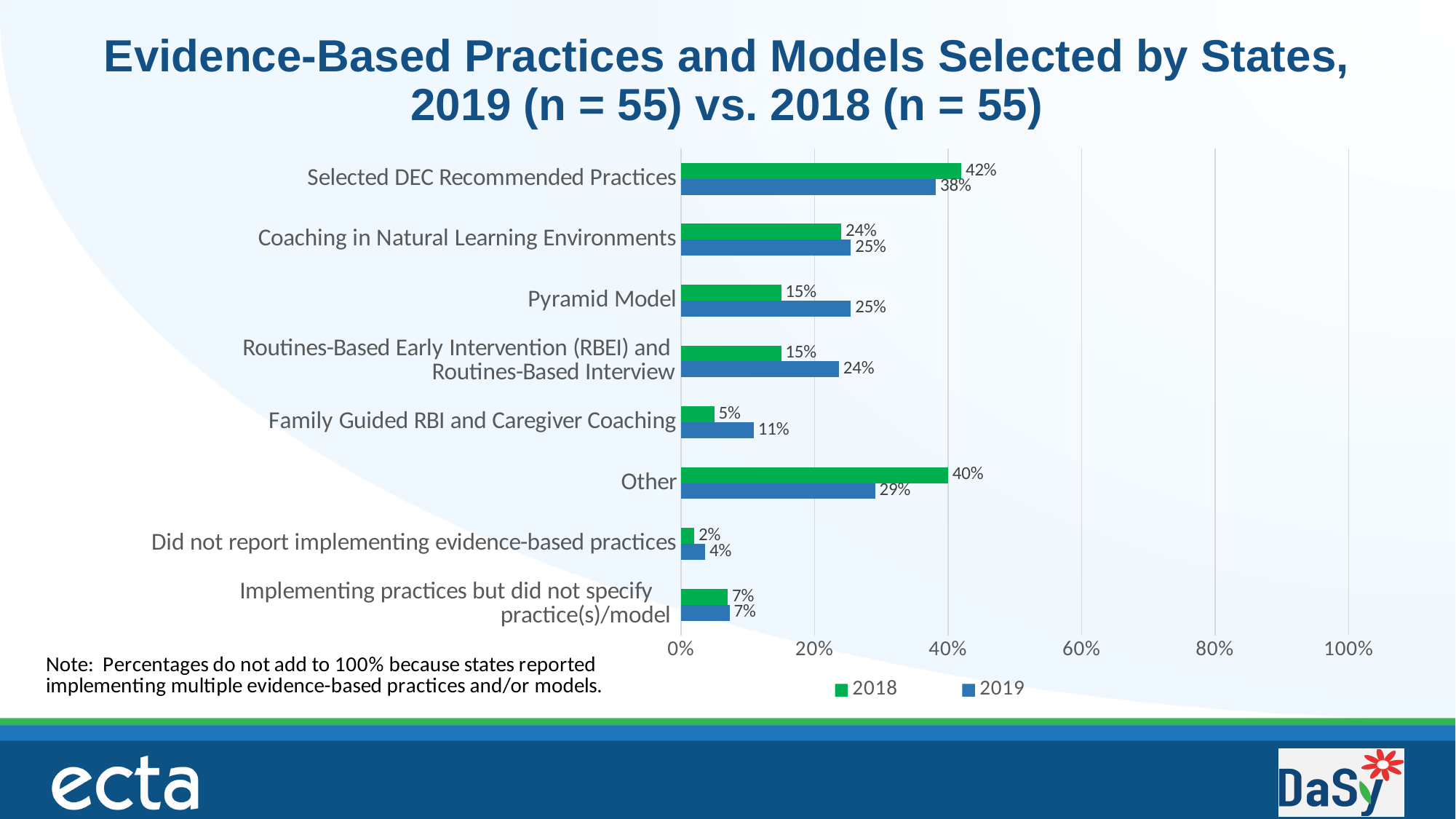
What is the 2019 value for Selected DEC Recommended Practices? 38% What is the difference between the 2018 and 2019 values for Other? 11% Which category has the highest 2018 value? Selected DEC Recommended Practices Which colour represents the 2019 series in the legend? Blue What is the 2019 value for Family Guided RBI and Caregiver Coaching? 11% What is the difference between the 2019 and 2018 values for Pyramid Model? 10% Which is larger for Routines-Based Early Intervention (RBEI) and Routines-Based Interview, the 2018 value or the 2019 value? 2019 Which category has the lowest 2019 value? Did not report implementing evidence-based practices What is the 2018 value for Pyramid Model? 15% What kind of chart is shown on the slide? Bar chart How many series does the legend list? 2 How many categories are shown on the chart? 8